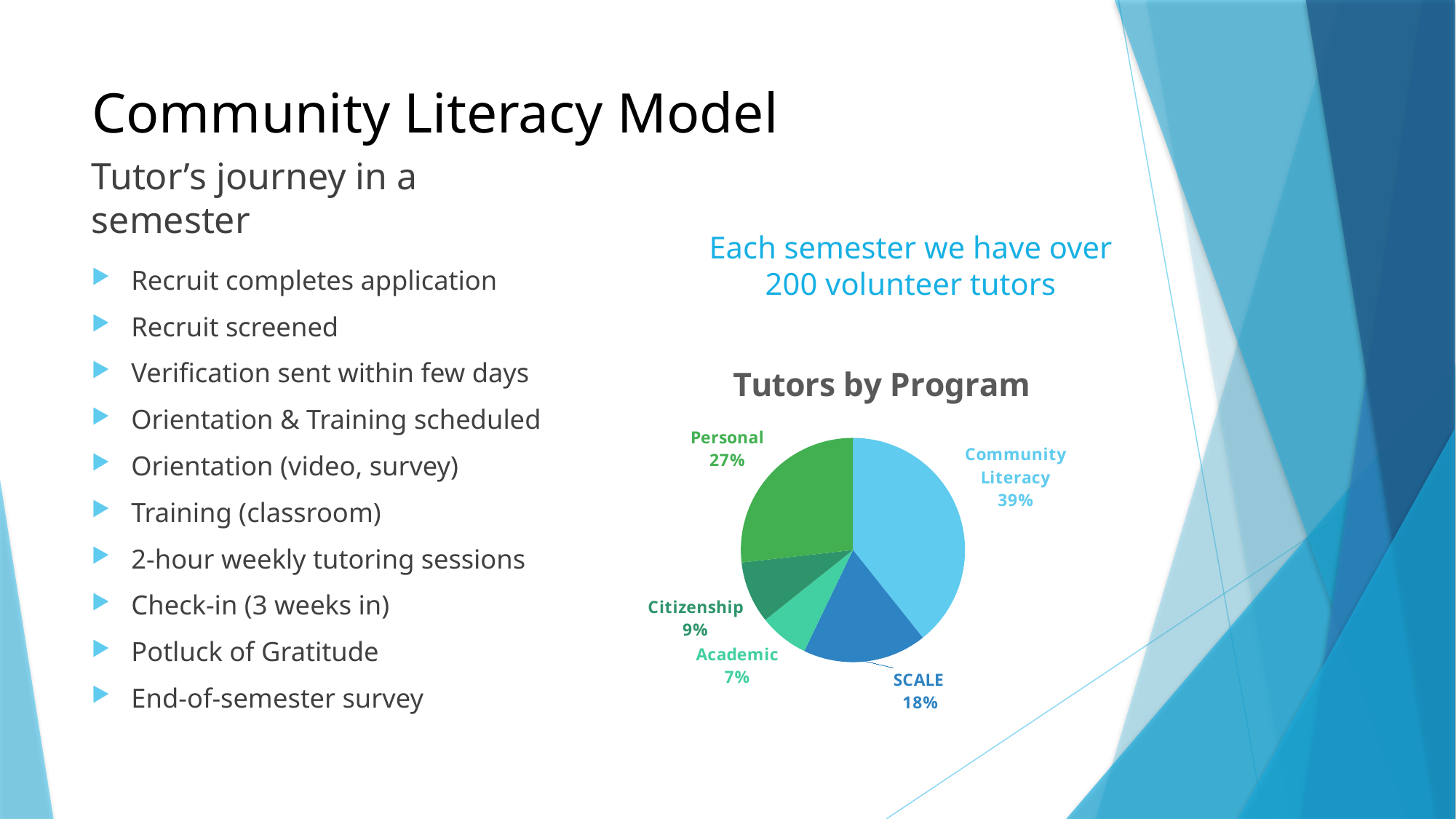
How many programs are shown in the pie chart? 5 What share of tutors is in the Academic program? 7% What is the difference in percentage points between the Community Literacy and Personal shares? 12 What share of tutors is in the Personal program? 27% Which program has the largest share of tutors? Community Literacy What share of tutors is in the Citizenship program? 9% What share of tutors is in the Community Literacy program? 39% What share of tutors is in the SCALE program? 18% What is the title of the chart? Tutors by Program Which has a larger share of tutors, SCALE or Citizenship? SCALE Which program has the smallest share of tutors? Academic What kind of chart is shown on the slide? pie chart